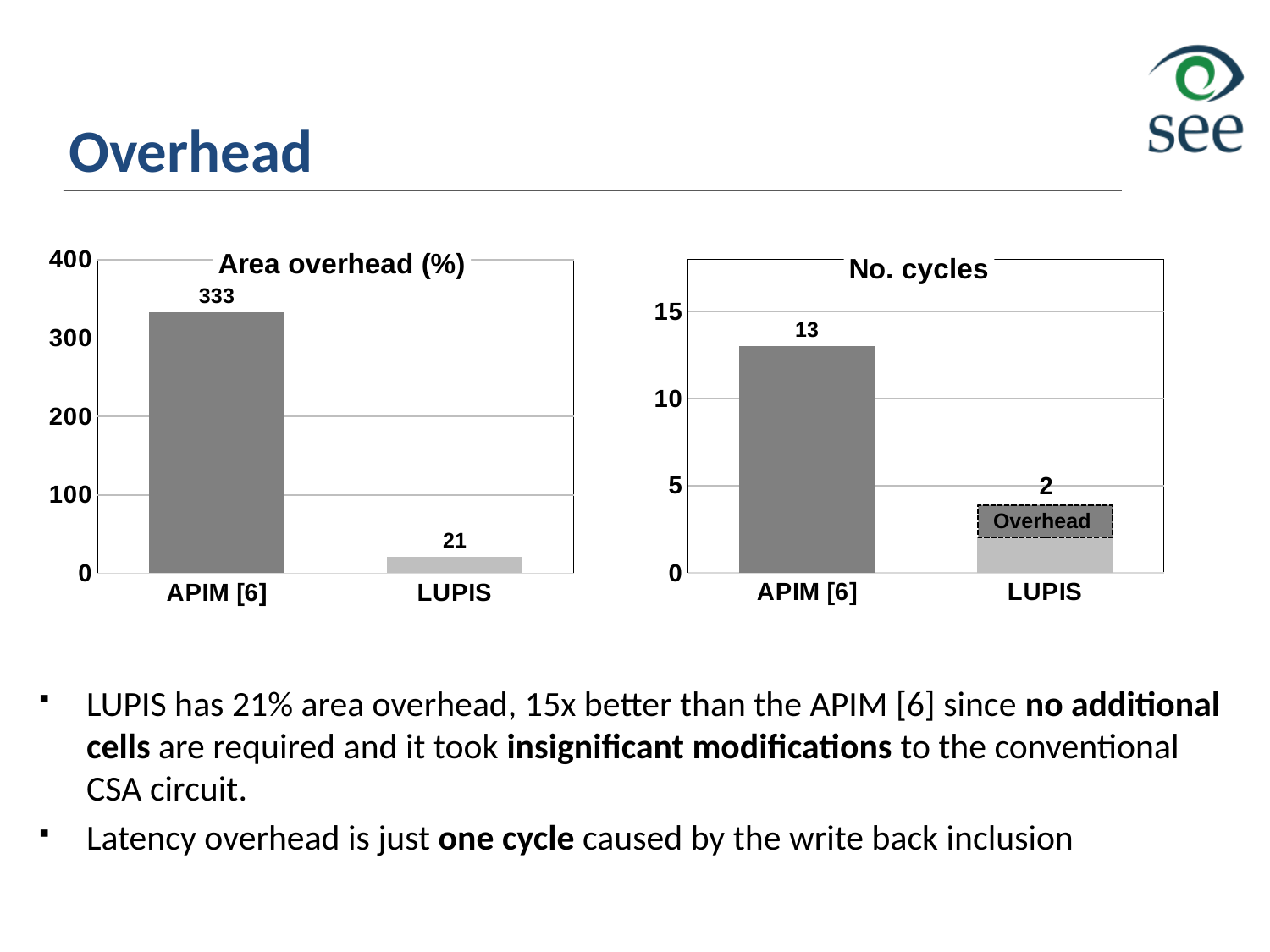
In the No. cycles chart, what is the difference between the values for APIM [6] and LUPIS? 11 In the Area overhead (%) chart, what is the value for APIM [6]? 333 In the Area overhead (%) chart, what is the value for LUPIS? 21 In the Area overhead (%) chart, which category has the highest value? APIM [6] In the No. cycles chart, what is the value for APIM [6]? 13 In the No. cycles chart, what is the value labelled for LUPIS? 2 In the Area overhead (%) chart, is the value for APIM [6] greater or less than 300? greater In the No. cycles chart, which category has the lowest value? LUPIS What kind of chart is the No. cycles chart? bar chart How many categories are shown in the Area overhead (%) chart? 2 In the Area overhead (%) chart, what is the difference between the values for APIM [6] and LUPIS? 312 In the No. cycles chart, which is larger, the value for APIM [6] or the value for LUPIS? APIM [6]